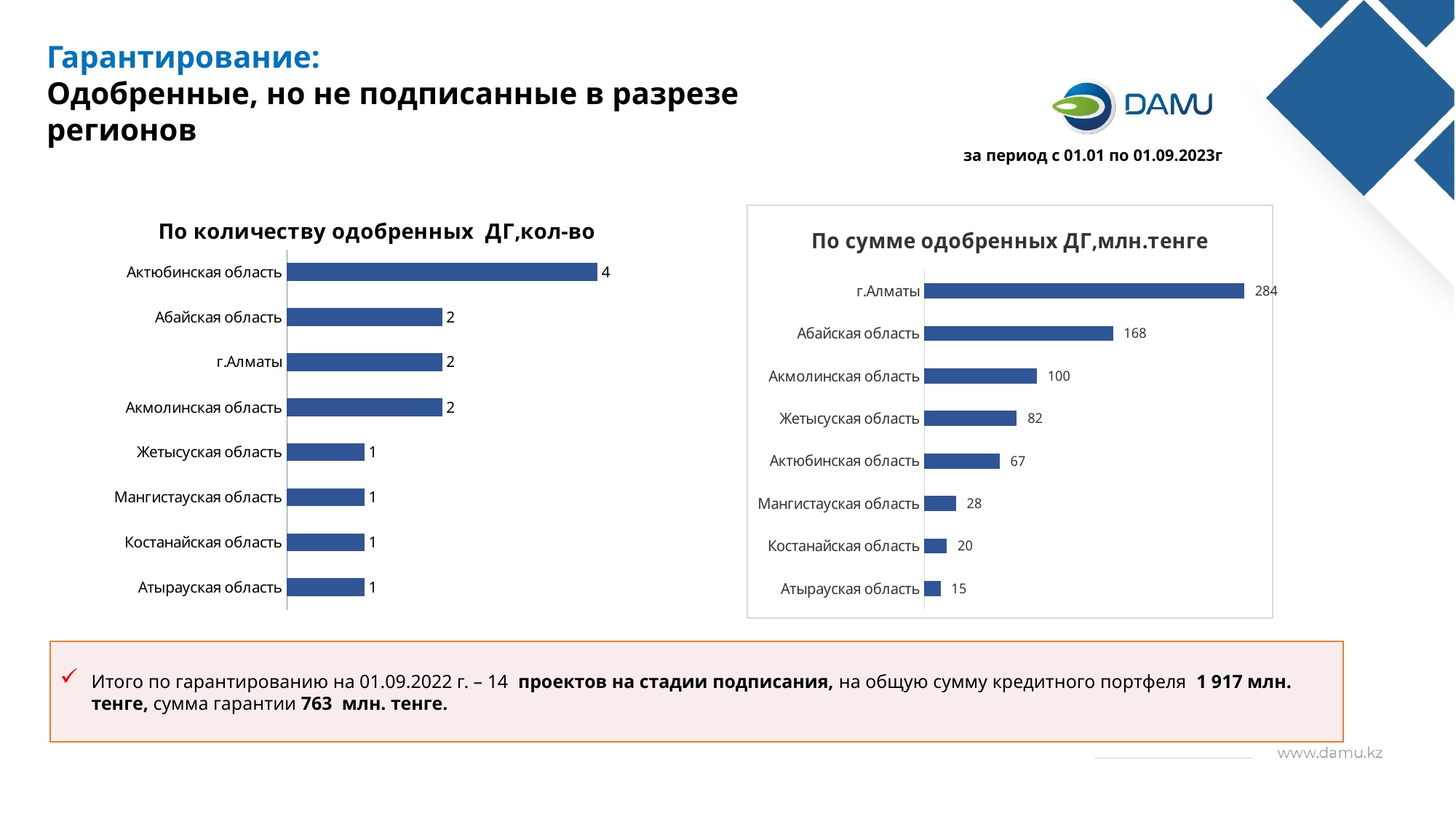
In the chart 'По сумме одобренных ДГ,млн.тенге', what is the value for г.Алматы? 284 In the chart 'По количеству одобренных ДГ,кол-во', what is the difference between Актюбинская область and Абайская область? 2 In the chart 'По количеству одобренных ДГ,кол-во', which region has the highest value? Актюбинская область In the chart 'По сумме одобренных ДГ,млн.тенге', what is the value for Мангистауская область? 28 In the chart 'По сумме одобренных ДГ,млн.тенге', which region has the lowest value? Атырауская область In the chart 'По сумме одобренных ДГ,млн.тенге', what is the difference between г.Алматы and Абайская область? 116 What type of chart is 'По сумме одобренных ДГ,млн.тенге'? Bar chart In the chart 'По сумме одобренных ДГ,млн.тенге', which is larger: Акмолинская область or Актюбинская область? Акмолинская область In the chart 'По сумме одобренных ДГ,млн.тенге', which region has the highest value? г.Алматы In the chart 'По количеству одобренных ДГ,кол-во', what is the value for Актюбинская область? 4 In the chart 'По количеству одобренных ДГ,кол-во', how many regions are shown? 8 In the chart 'По сумме одобренных ДГ,млн.тенге', what is the value for Жетысуская область? 82